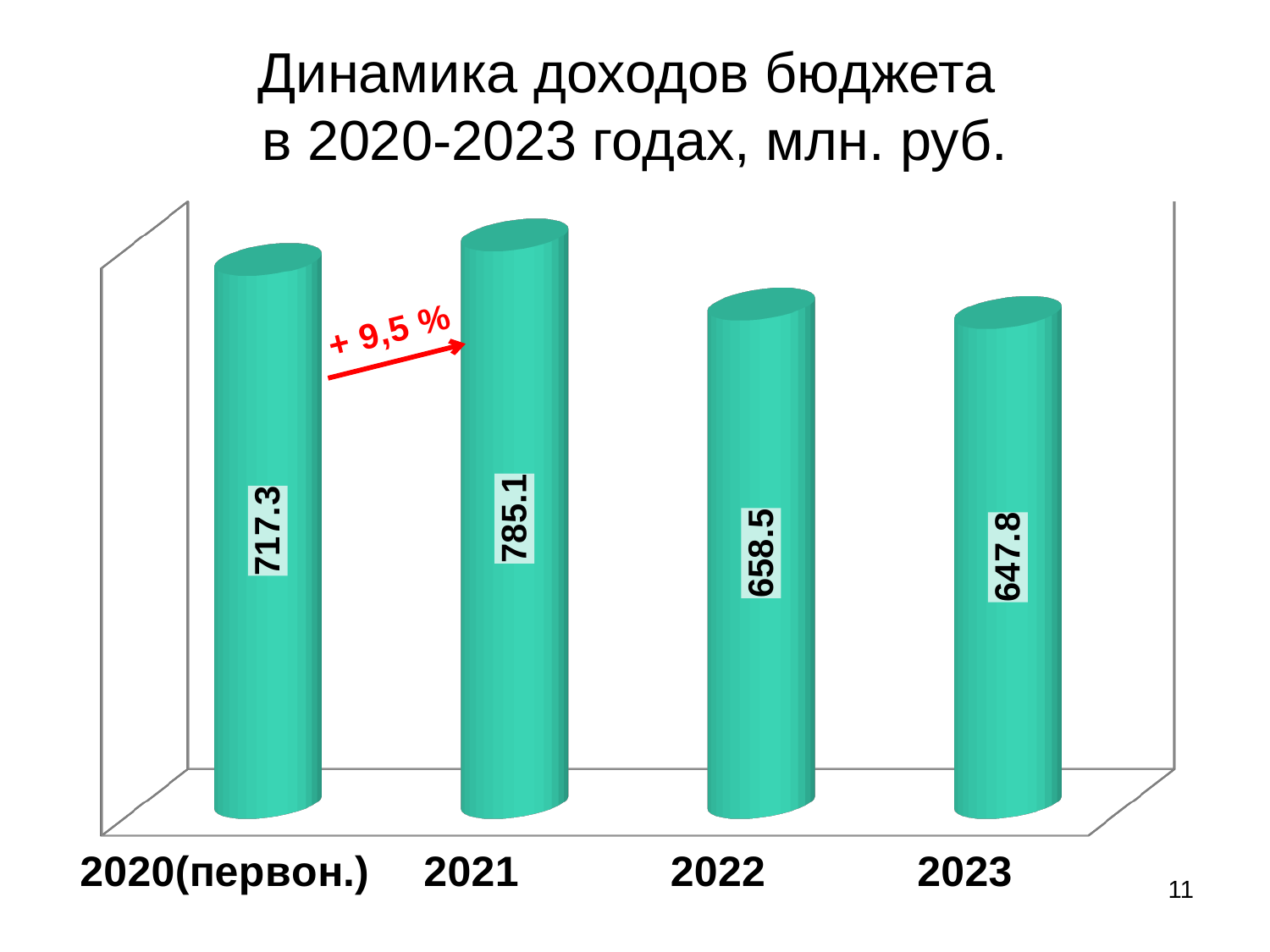
What is the value for 2021? 785.1 What is the value for 2023? 647.8 What is the difference between the values for 2021 and 2020(первон.)? 67.8 What percentage change is shown by the red arrow between 2020(первон.) and 2021? + 9,5 % What is the value for 2022? 658.5 Which is larger, the value for 2020(первон.) or the value for 2022? 2020(первон.) Which year has the highest value? 2021 What kind of chart is shown on the slide? Bar chart How many bars are shown in the chart? 4 What is the value for 2020(первон.)? 717.3 What is the difference between the values for 2022 and 2023? 10.7 Which year has the lowest value? 2023